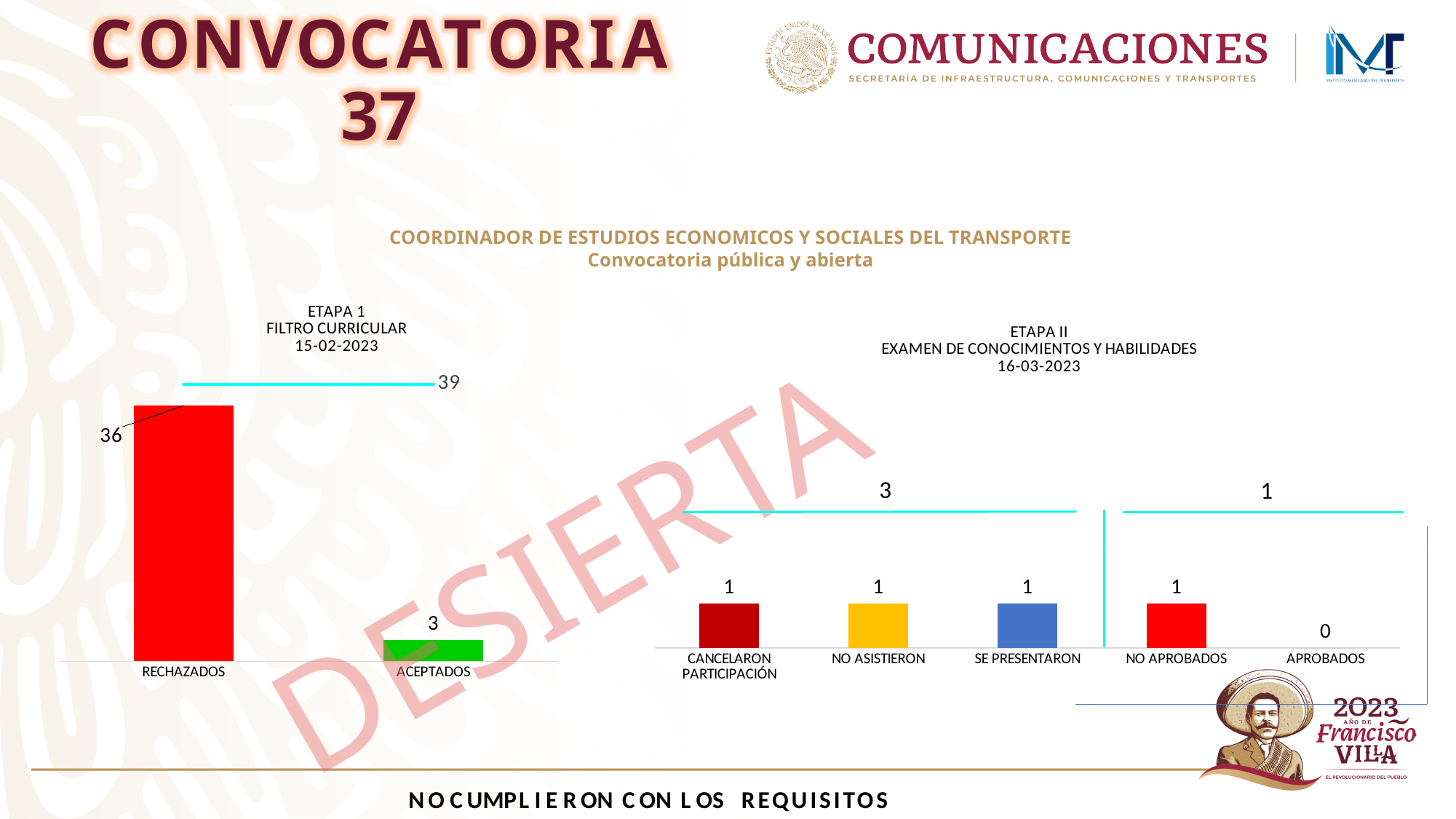
In the ETAPA 1 chart, which category has the highest value? RECHAZADOS In the ETAPA 1 chart, what is the value for ACEPTADOS? 3 In the ETAPA II chart, how many categories are plotted? 5 In the ETAPA II chart, is the value for NO APROBADOS larger or smaller than the value for APROBADOS? larger In the ETAPA II chart, which category has the lowest value? APROBADOS In the ETAPA 1 chart, what total is shown above the bracket spanning both bars? 39 In the ETAPA 1 chart, what is the value for RECHAZADOS? 36 What kind of chart is the ETAPA 1 chart? bar chart In the ETAPA II chart, what is the value for APROBADOS? 0 In the ETAPA II chart, what is the value for SE PRESENTARON? 1 In the ETAPA 1 chart, how many categories are plotted? 2 In the ETAPA 1 chart, what is the difference between RECHAZADOS and ACEPTADOS? 33